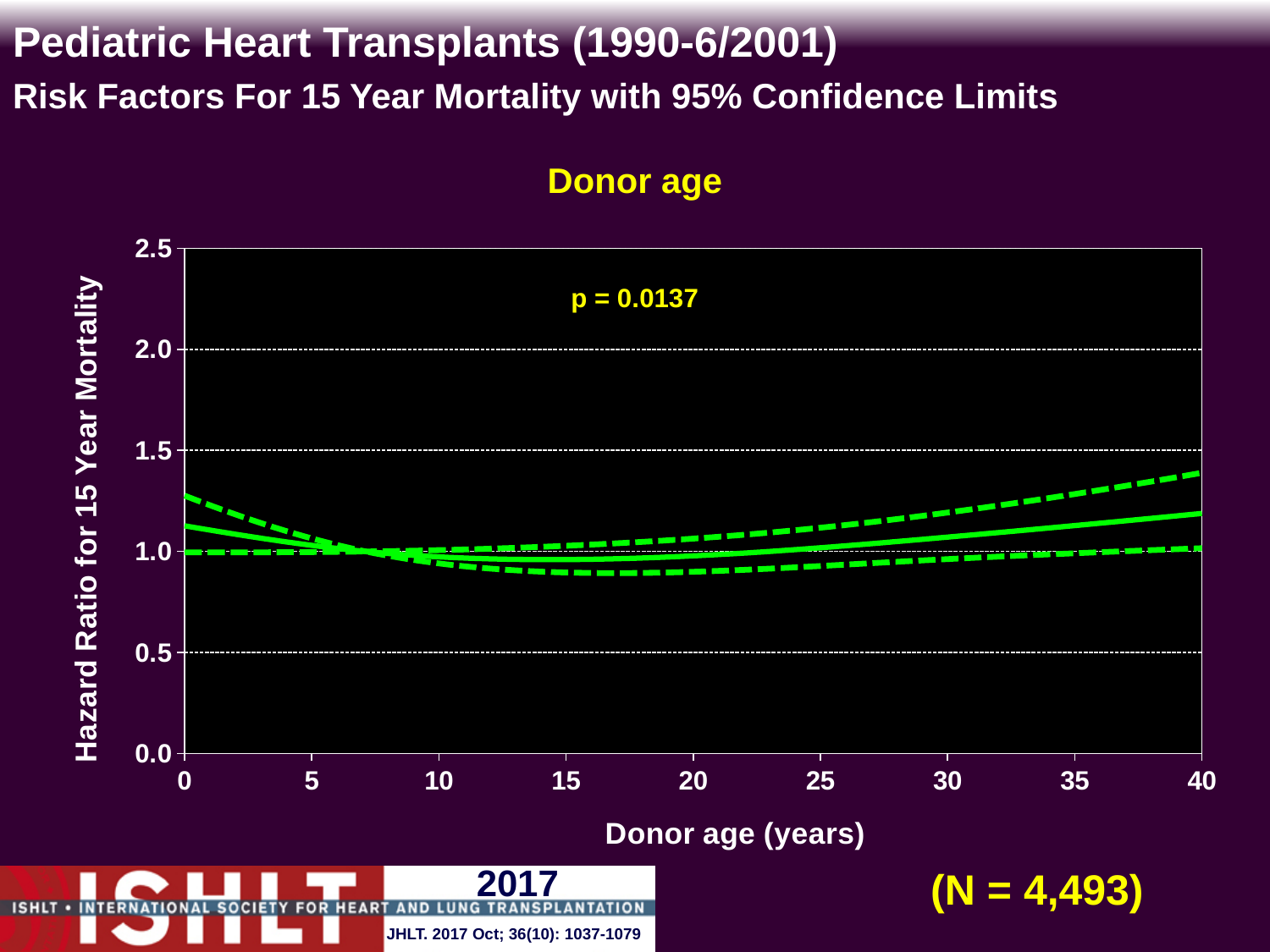
What kind of chart is shown on the slide? line chart What is the highest value labelled on the Hazard Ratio (y) axis? 2.5 At a donor age of 15 years, is the lower dashed confidence limit greater or less than 1.0? less At a donor age of 40 years, is the upper dashed confidence limit greater or less than 1.5? less At a donor age of 0 years, is the hazard ratio on the solid line greater or less than 1.5? less Does the solid hazard ratio line rise or fall as donor age increases from 20 to 40 years? rise What is the title of the chart? Donor age What p-value is printed on the chart? p = 0.0137 Does the upper dashed confidence limit rise or fall as donor age increases from 0 to 10 years? fall How many labelled tick marks are on the donor age (x) axis? 9